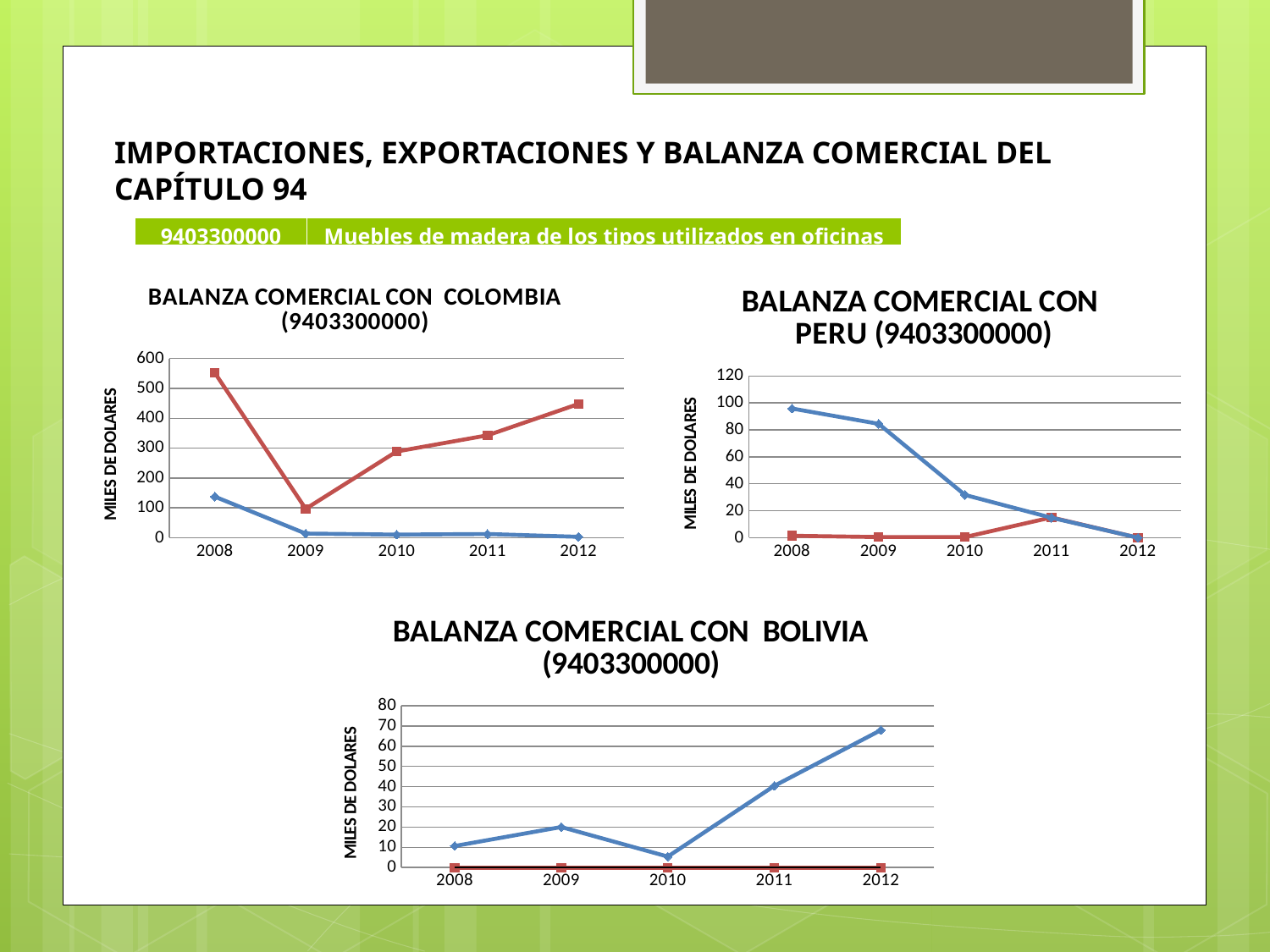
What is the y-axis label of the 'BALANZA COMERCIAL CON BOLIVIA (9403300000)' chart? MILES DE DOLARES In the 'BALANZA COMERCIAL CON PERU (9403300000)' chart, is the value of the blue line in 2008 greater or less than 80? greater In the 'BALANZA COMERCIAL CON BOLIVIA (9403300000)' chart, is the value of the blue line in 2012 greater or less than 60? greater In the 'BALANZA COMERCIAL CON COLOMBIA (9403300000)' chart, is the value of the red line in 2008 greater or less than 500? greater In the 'BALANZA COMERCIAL CON PERU (9403300000)' chart, in which year is the blue line at its highest? 2008 In the 'BALANZA COMERCIAL CON COLOMBIA (9403300000)' chart, which line is higher in 2012, the red line or the blue line? the red line In the 'BALANZA COMERCIAL CON PERU (9403300000)' chart, does the blue line rise or fall from 2008 to 2012? fall In the 'BALANZA COMERCIAL CON COLOMBIA (9403300000)' chart, in which year is the red line at its highest? 2008 What kind of chart is the 'BALANZA COMERCIAL CON COLOMBIA (9403300000)' chart? line chart In the 'BALANZA COMERCIAL CON BOLIVIA (9403300000)' chart, in which year is the blue line at its highest? 2012 How many years are shown on the x axis of the 'BALANZA COMERCIAL CON COLOMBIA (9403300000)' chart? 5 In the 'BALANZA COMERCIAL CON COLOMBIA (9403300000)' chart, in which year is the red line at its lowest? 2009